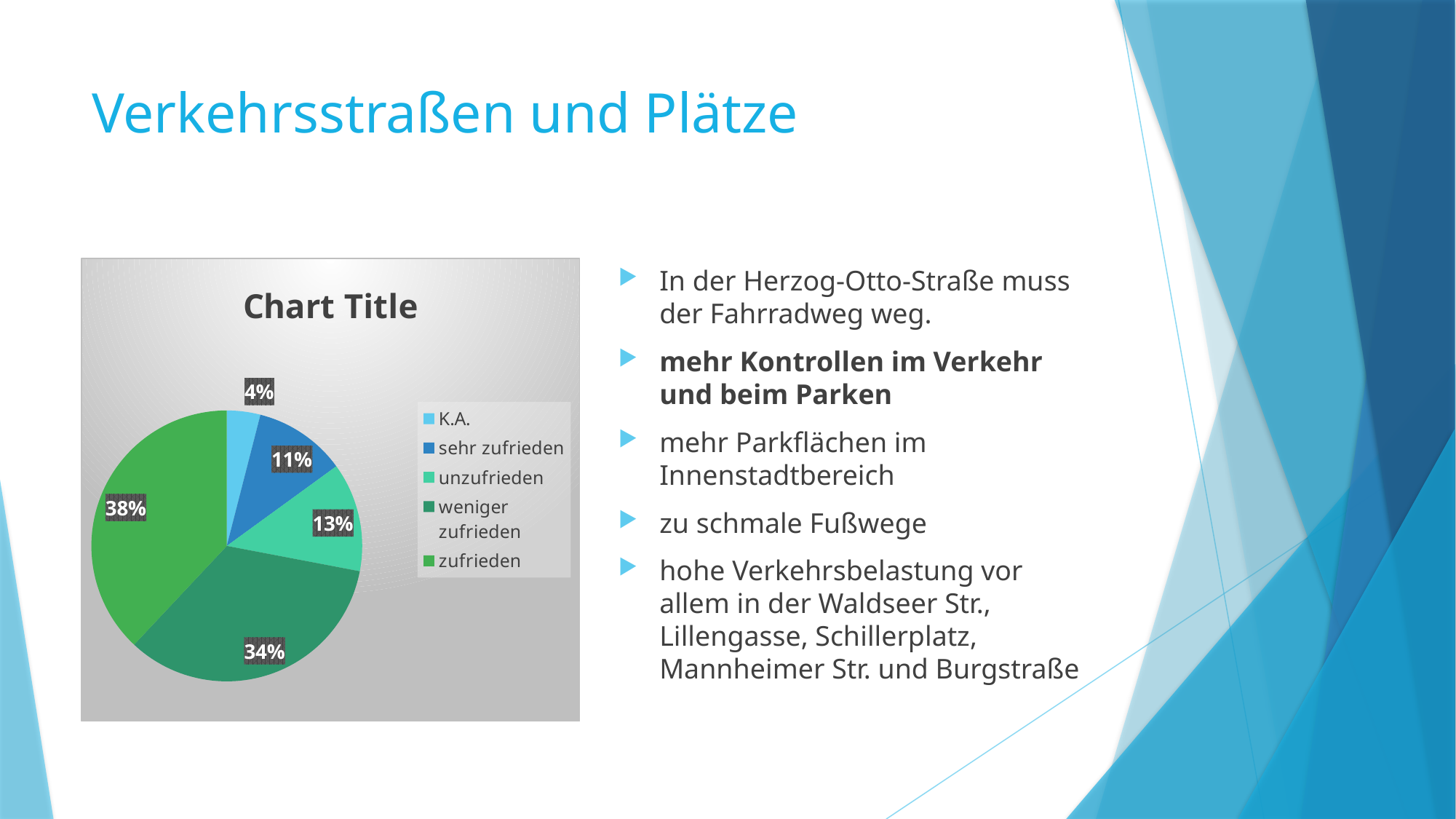
What percentage of the pie is labelled 'zufrieden'? 38% Which category has the largest share of the pie? zufrieden Which is larger, the share for 'unzufrieden' or the share for 'sehr zufrieden'? unzufrieden What percentage of the pie is labelled 'weniger zufrieden'? 34% Which category has the smallest share of the pie? K.A. What is the difference in percentage points between 'zufrieden' and 'weniger zufrieden'? 4 Which legend entry is shown in light blue? K.A. What kind of chart is shown on the slide? pie chart How many slices does the pie chart have? 5 What is the title of the chart? Chart Title What percentage of the pie is labelled 'sehr zufrieden'? 11% What percentage of the pie is labelled 'K.A.'? 4%